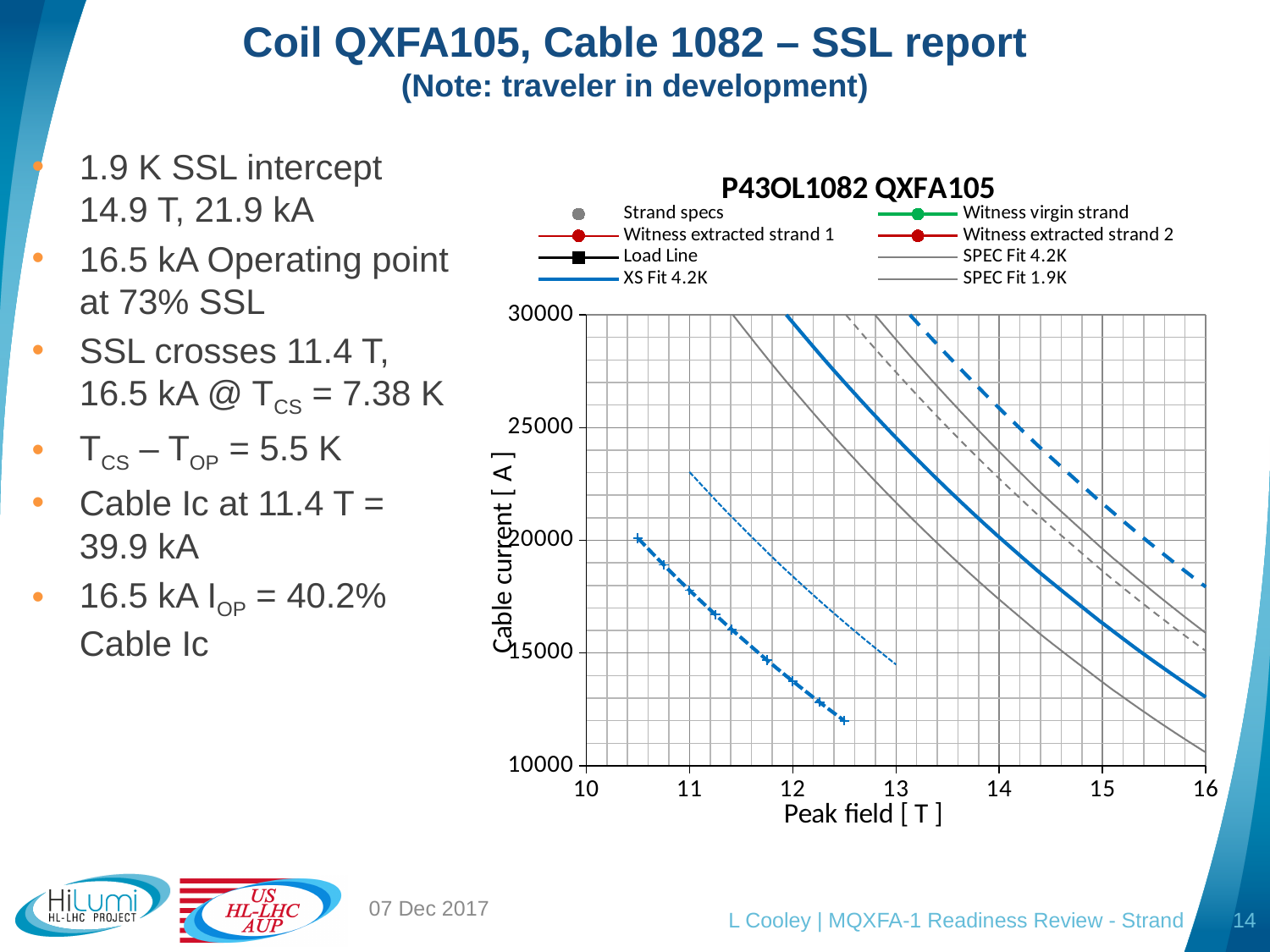
Does the XS Fit 4.2K curve rise or fall as peak field increases? fall What is the title of the chart? P43OL1082 QXFA105 Is the XS Fit 4.2K value at 16 T greater or less than 15000? less What kind of chart is shown on the slide? line chart Is the XS Fit 4.2K value at 13 T greater or less than 20000? greater What is the label of the x axis of the chart? Peak field [ T ] What is the label of the y axis of the chart? Cable current [ A ] How many series does the chart legend list? 8